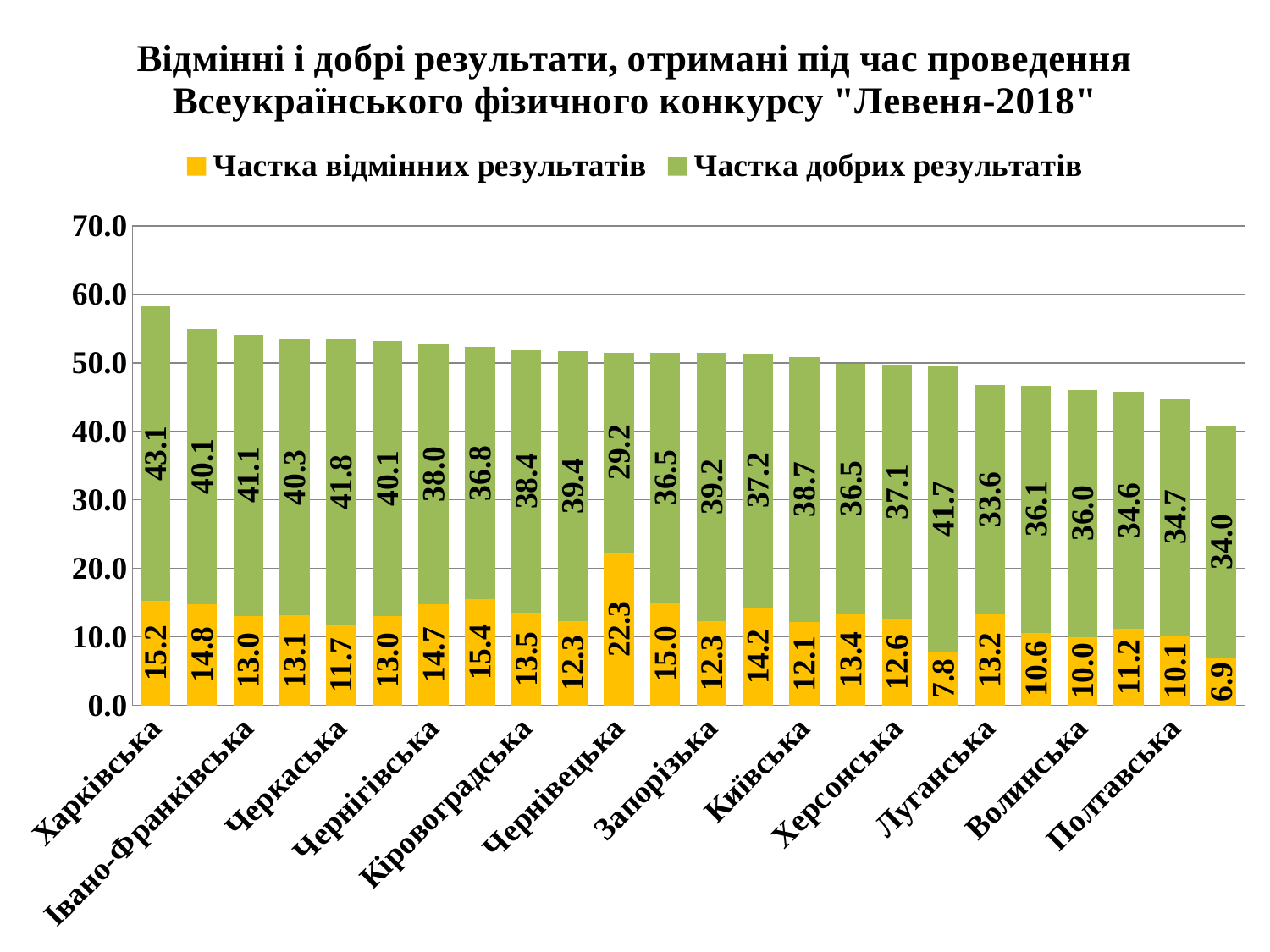
What is the value of 'Частка добрих результатів' for Харківська? 43.1 What is the value of 'Частка добрих результатів' for Чернівецька? 29.2 What kind of chart is shown on the slide? Stacked bar chart How many series does the legend list? 2 What is the value of 'Частка відмінних результатів' for Харківська? 15.2 What is the value of 'Частка відмінних результатів' for Чернівецька? 22.3 Which has the larger 'Частка добрих результатів', Харківська or Чернівецька? Харківська What is the total of the stacked bar for Харківська? 58.3 What is the total of the stacked bar for Чернівецька? 51.5 Do the total bar heights rise or fall from left to right along the x axis? Fall Which region has the highest 'Частка відмінних результатів'? Чернівецька What is the difference between the 'Частка добрих результатів' of Харківська and Чернівецька? 13.9